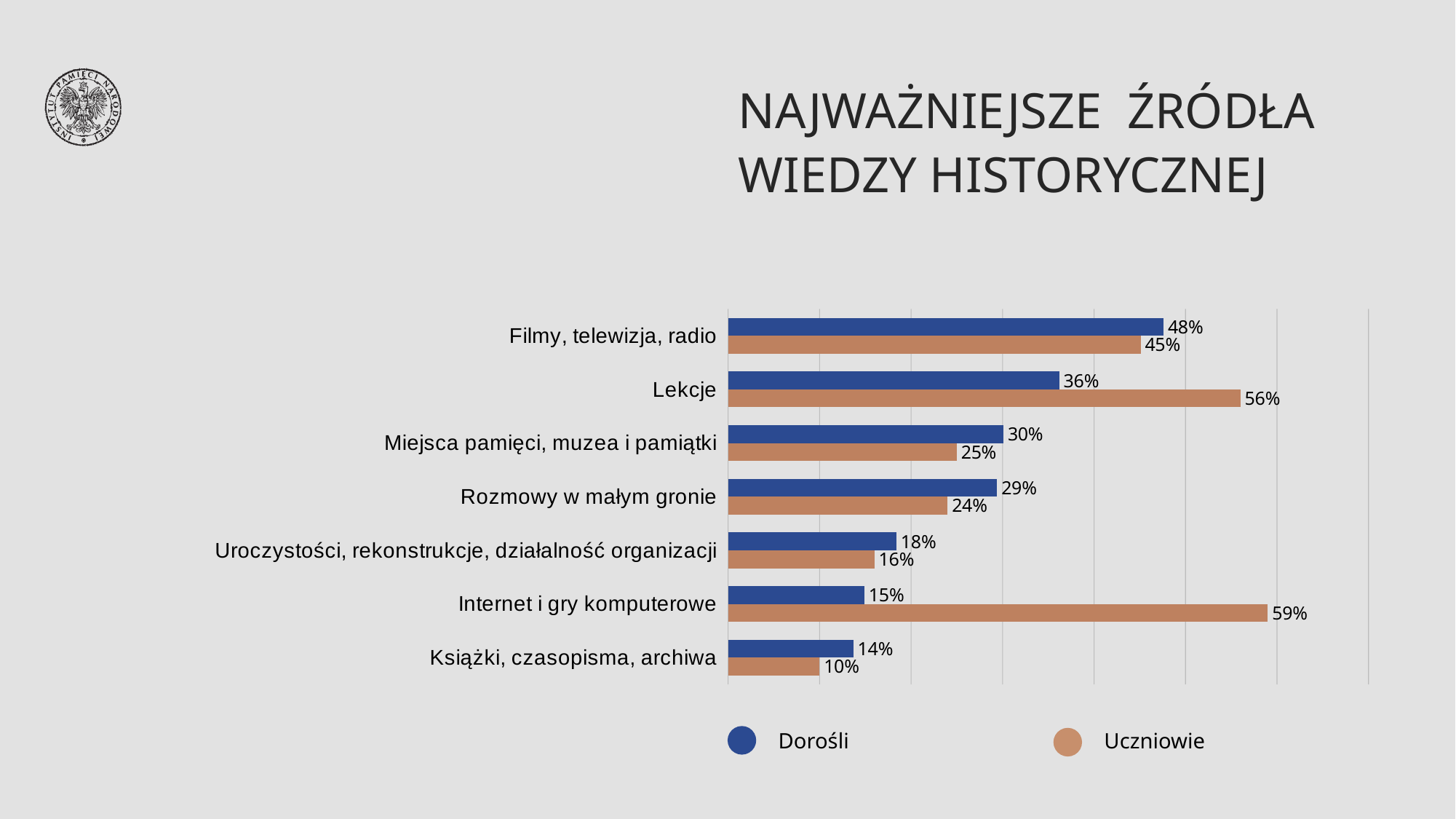
What is the difference between the Dorośli and Uczniowie values for Miejsca pamięci, muzea i pamiątki? 5% Which colour represents the Uczniowie series? Orange/brown What is the difference between the Uczniowie and Dorośli values for Internet i gry komputerowe? 44% Which is larger for Lekcje: the Dorośli value or the Uczniowie value? Uczniowie How many series does the legend list? 2 What kind of chart is shown on the slide? Bar chart How many categories are shown on the chart? 7 What is the value for Dorośli for Lekcje? 36% Which category has the highest value for Dorośli? Filmy, telewizja, radio What is the value for Uczniowie for Książki, czasopisma, archiwa? 10% What is the value for Uczniowie for Internet i gry komputerowe? 59% Which category has the lowest value for Uczniowie? Książki, czasopisma, archiwa